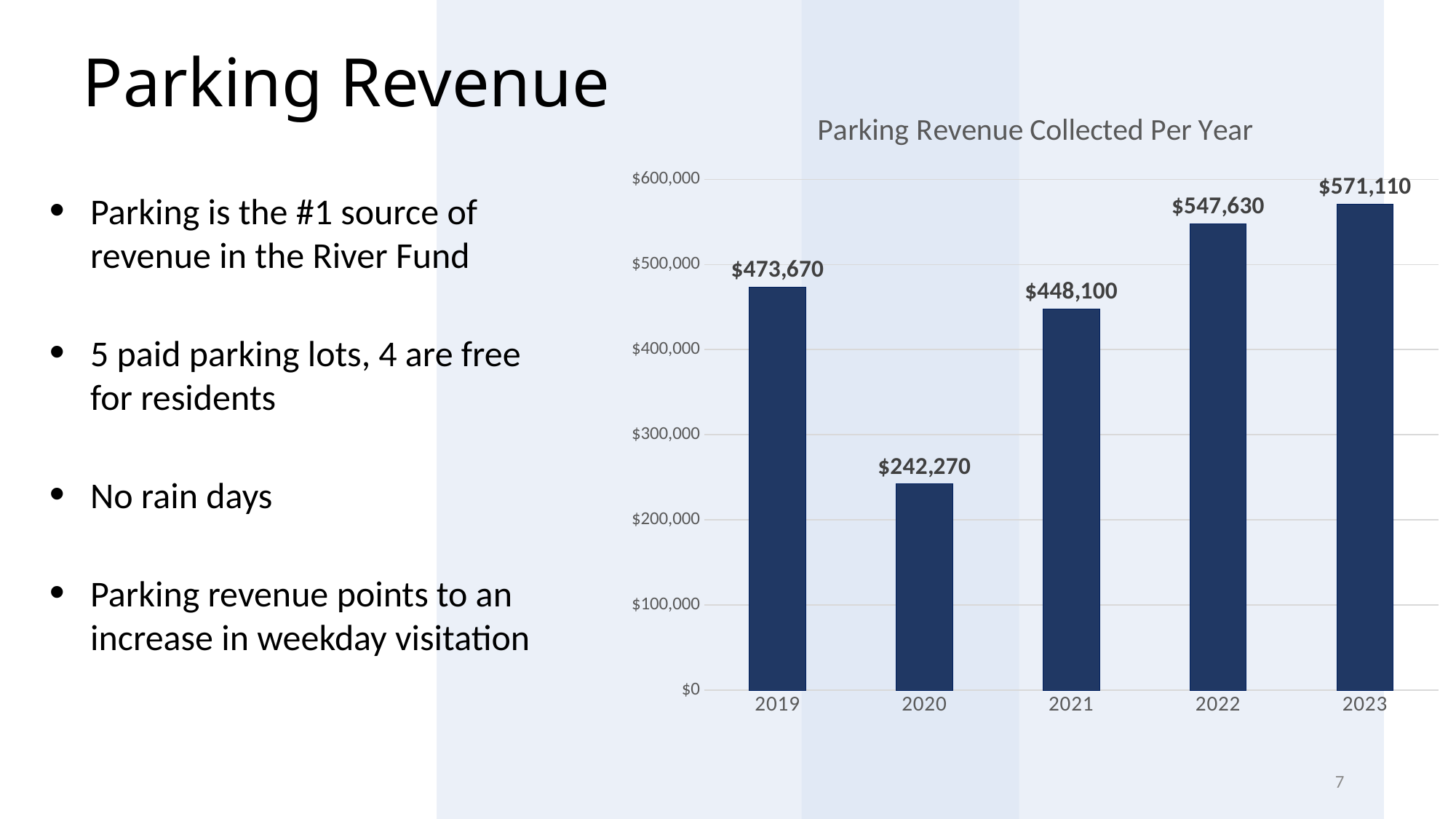
What was the parking revenue collected in 2019? $473,670 What was the parking revenue collected in 2022? $547,630 Which year had the highest parking revenue? 2023 How many years are shown in the chart? 5 Which year had higher parking revenue, 2019 or 2021? 2019 Is the parking revenue for 2021 greater or less than $400,000? greater Which year had the lowest parking revenue? 2020 What was the parking revenue collected in 2020? $242,270 What kind of chart is used to show parking revenue? Bar chart What is the title of the chart? Parking Revenue Collected Per Year What is the difference between the parking revenue in 2019 and in 2020? $231,400 What is the difference between the parking revenue in 2023 and in 2022? $23,480